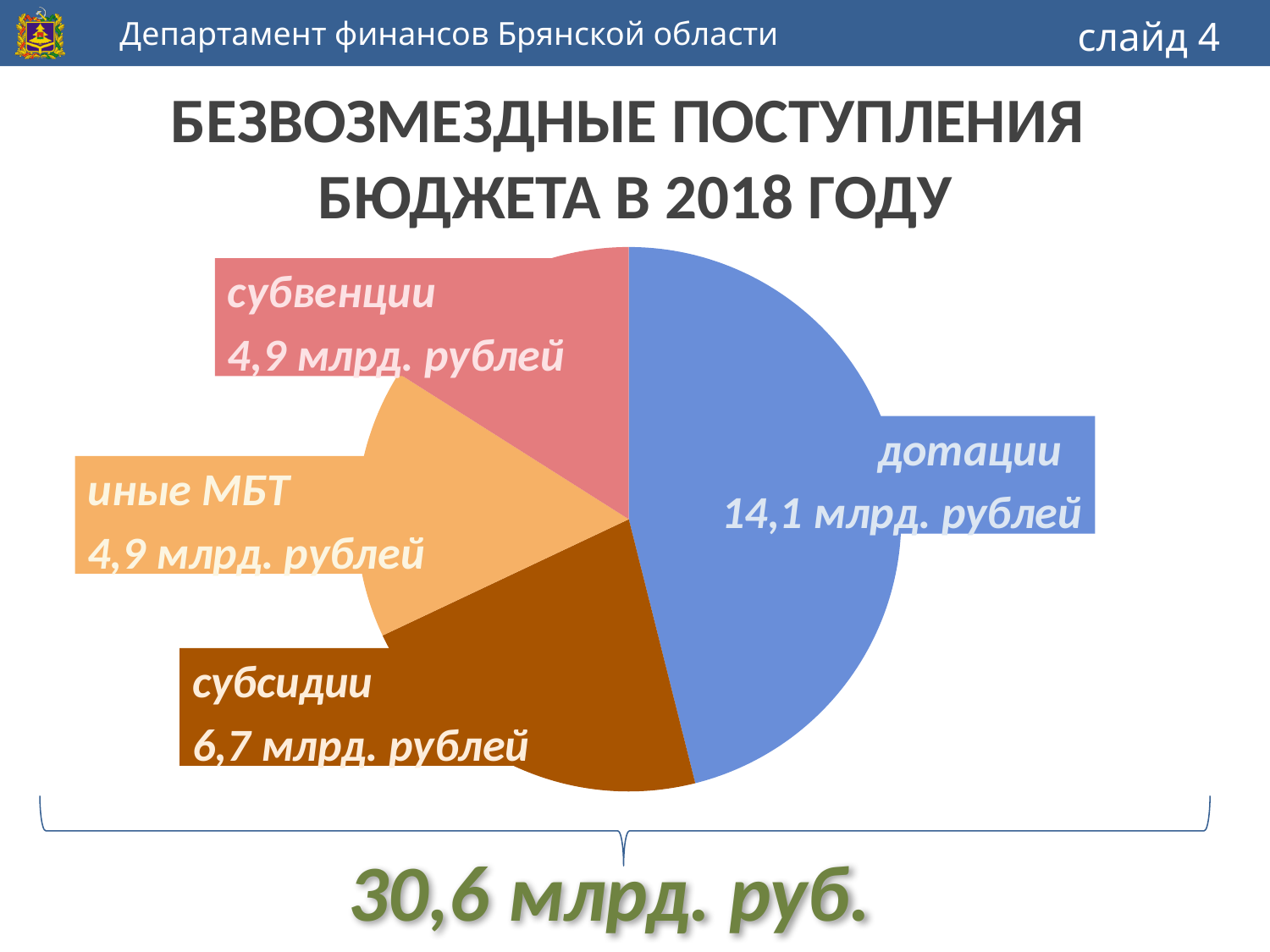
What is the value for дотации? 14,1 млрд. рублей What is the difference between субсидии and иные МБТ? 1,8 млрд. рублей What is the title of the slide containing the pie chart? БЕЗВОЗМЕЗДНЫЕ ПОСТУПЛЕНИЯ БЮДЖЕТА В 2018 ГОДУ How many slices does the pie chart have? 4 What is the value for иные МБТ? 4,9 млрд. рублей What is the difference between дотации and субсидии? 7,4 млрд. рублей What is the value for субсидии? 6,7 млрд. рублей What is the value for субвенции? 4,9 млрд. рублей Which category has the largest slice of the pie? дотации What is the total of all categories shown under the pie chart? 30,6 млрд. руб. Which is larger, субсидии or субвенции? субсидии What type of chart is shown on the slide? pie chart